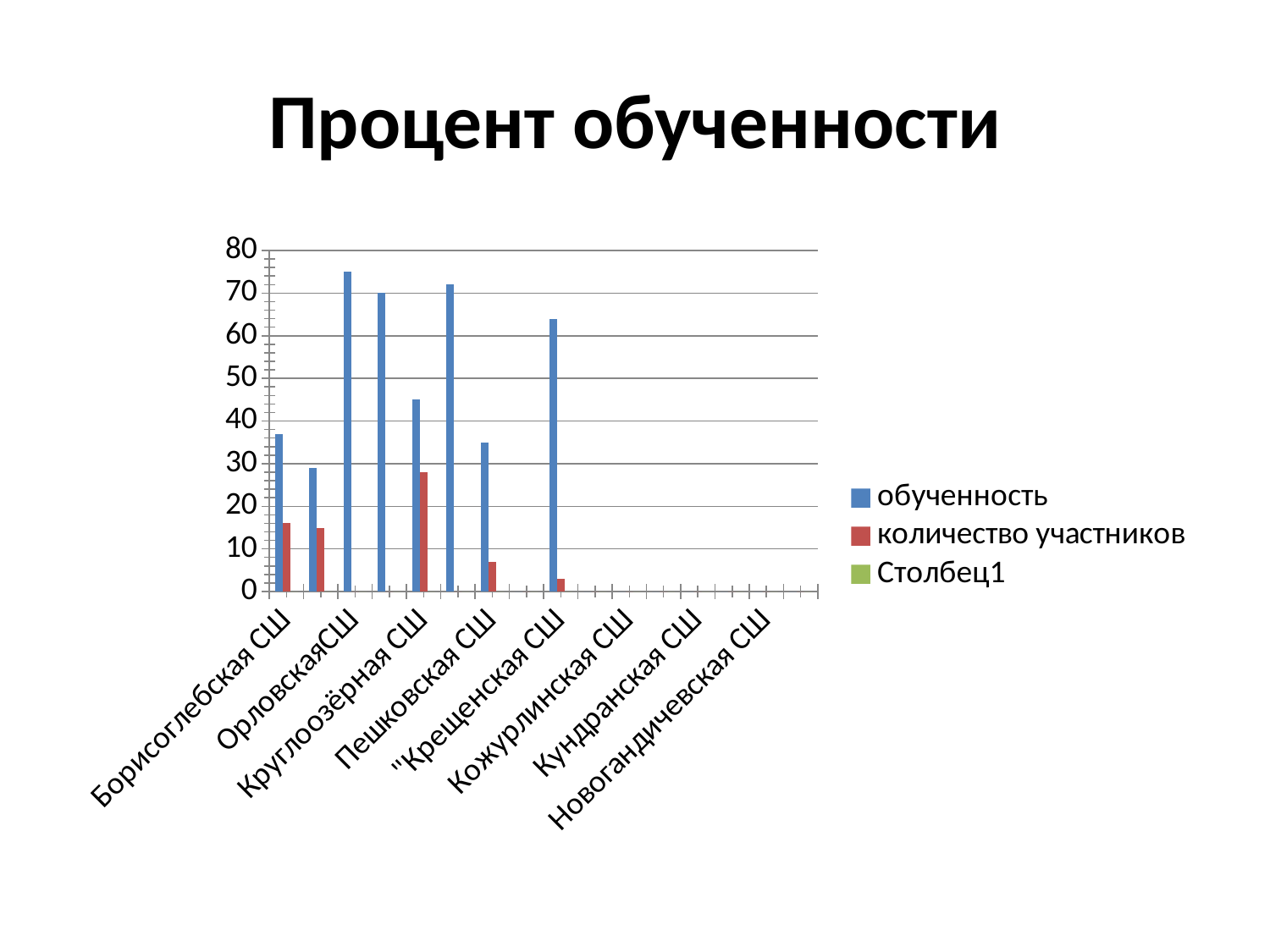
Is the обученность value for Орловская СШ greater or less than 70? greater What is the title of the chart? Процент обученности Is the количество участников value for Круглоозёрная СШ greater or less than 20? greater How many category labels are shown on the x axis? 8 How many series does the legend list? 3 What kind of chart is shown on the slide? bar chart Is the обученность value for Пешковская СШ greater or less than 40? less Which has the larger обученность value, Орловская СШ or Борисоглебская СШ? Орловская СШ Which series is shown in red in the legend? количество участников